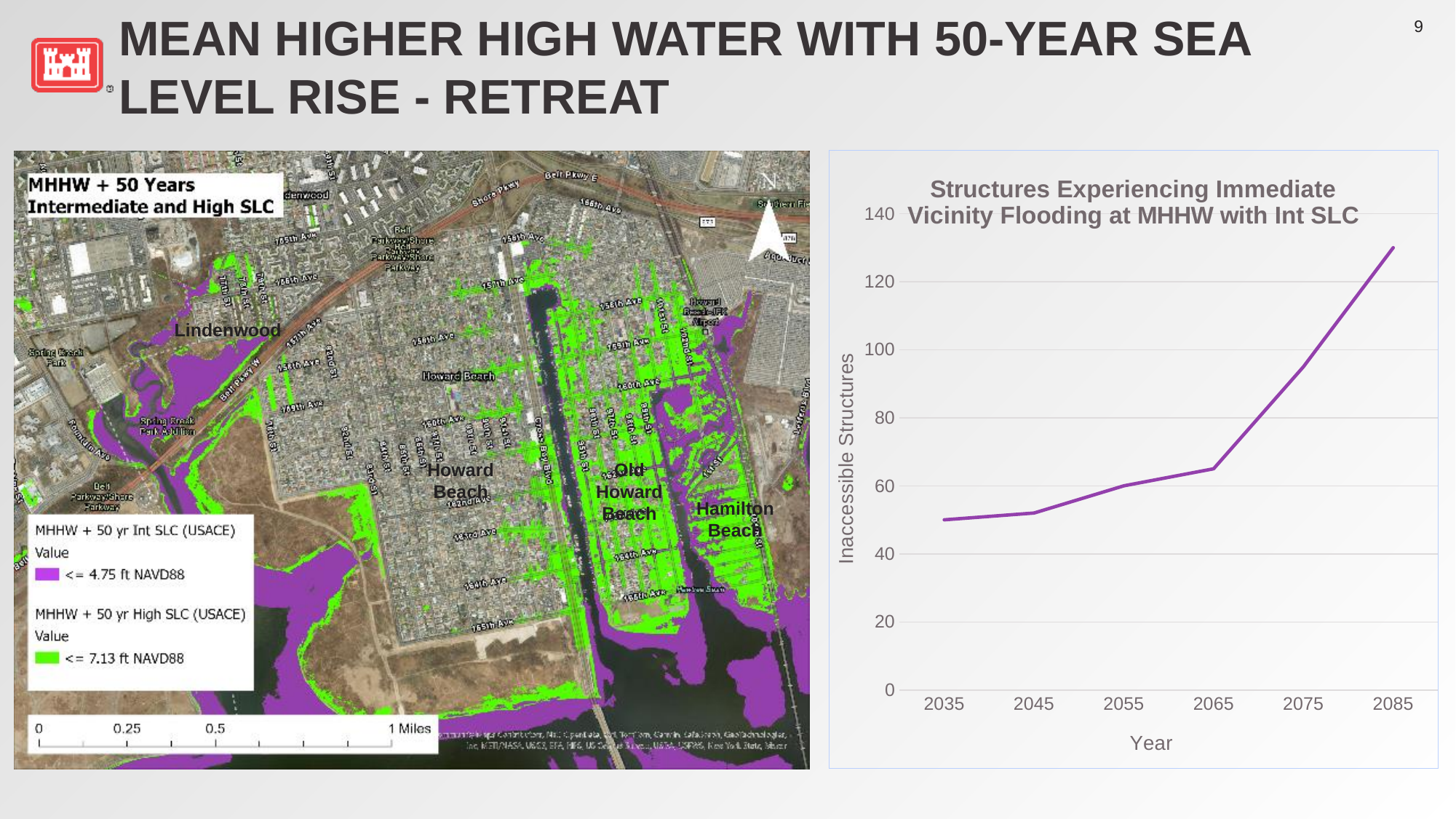
What is the label of the horizontal axis of the line chart? Year In the line chart, which is larger: the value for 2085 or the value for 2065? 2085 How many year labels are shown on the x axis of the line chart? 6 In the line chart, is the value for 2085 greater or less than 120? greater In the line chart, which year has the highest number of inaccessible structures? 2085 In the chart 'Structures Experiencing Immediate Vicinity Flooding at MHHW with Int SLC', do the values rise or fall from 2035 to 2085? rise In the line chart, is the value for 2055 greater or less than 40? greater What kind of chart is shown on the right side of the slide? line chart What is the label of the vertical axis of the line chart? Inaccessible Structures In the line chart, is the value for 2065 greater or less than 80? less In the line chart, which is larger: the value for 2035 or the value for 2065? 2065